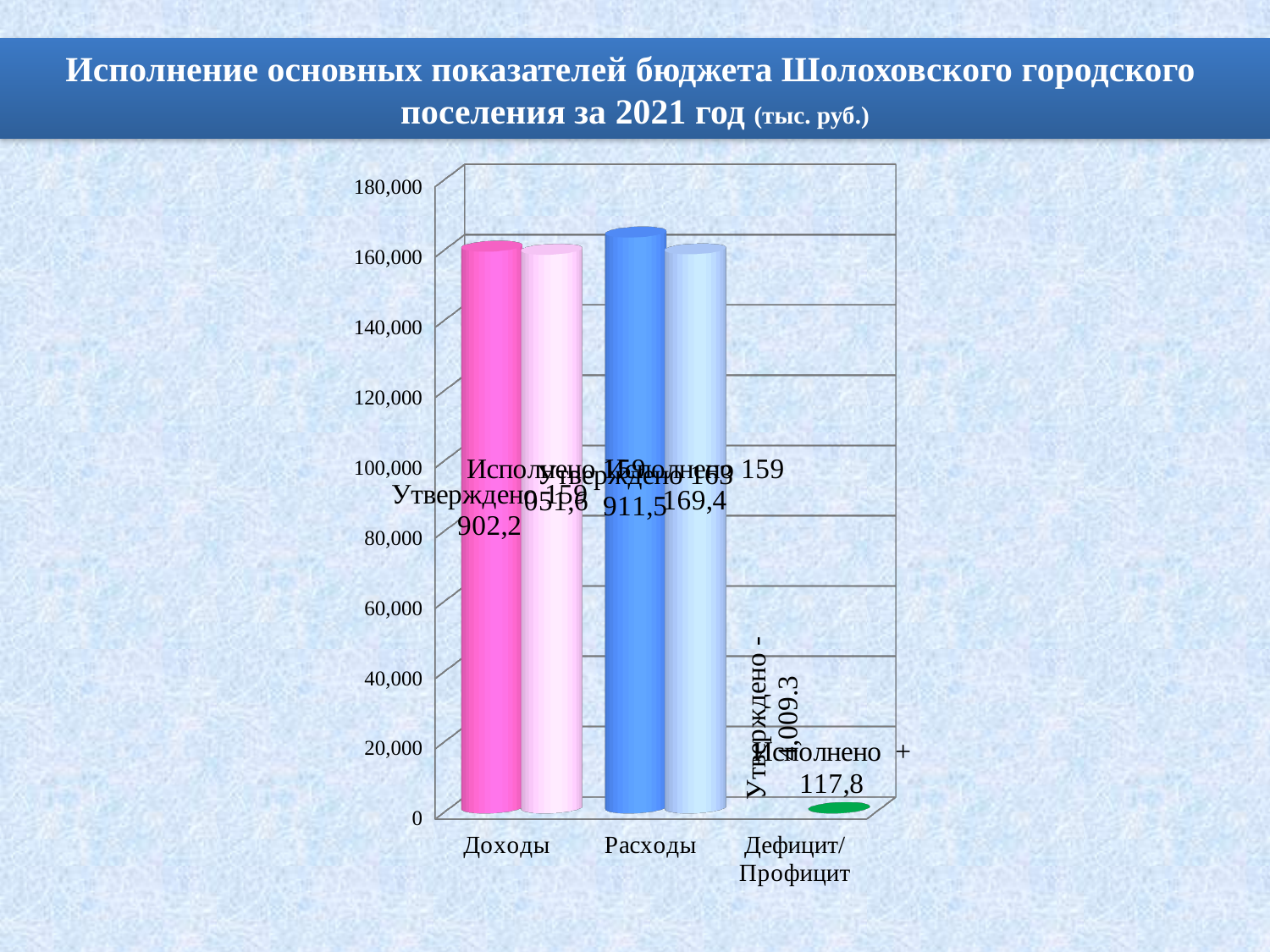
In what units are the values on the chart given, according to the slide title? тыс. руб. How many categories are shown on the x axis of the chart? 3 What is the Исполнено value for Дефицит/Профицит? +117,8 What is the Утверждено value for Расходы? 163 911,5 Which is larger: the Утверждено value for Расходы or the Утверждено value for Доходы? Расходы Which category has the tallest bar on the chart? Расходы Which category has the lowest values on the chart? Дефицит/Профицит What kind of chart is shown on the slide? bar chart What is the Исполнено value for Расходы? 159 169,4 Is the Исполнено value for Доходы greater or less than 140,000? greater What is the difference between the Утверждено value for Расходы and the Утверждено value for Доходы? 4 009,3 What is the Утверждено value for Доходы? 159 902,2